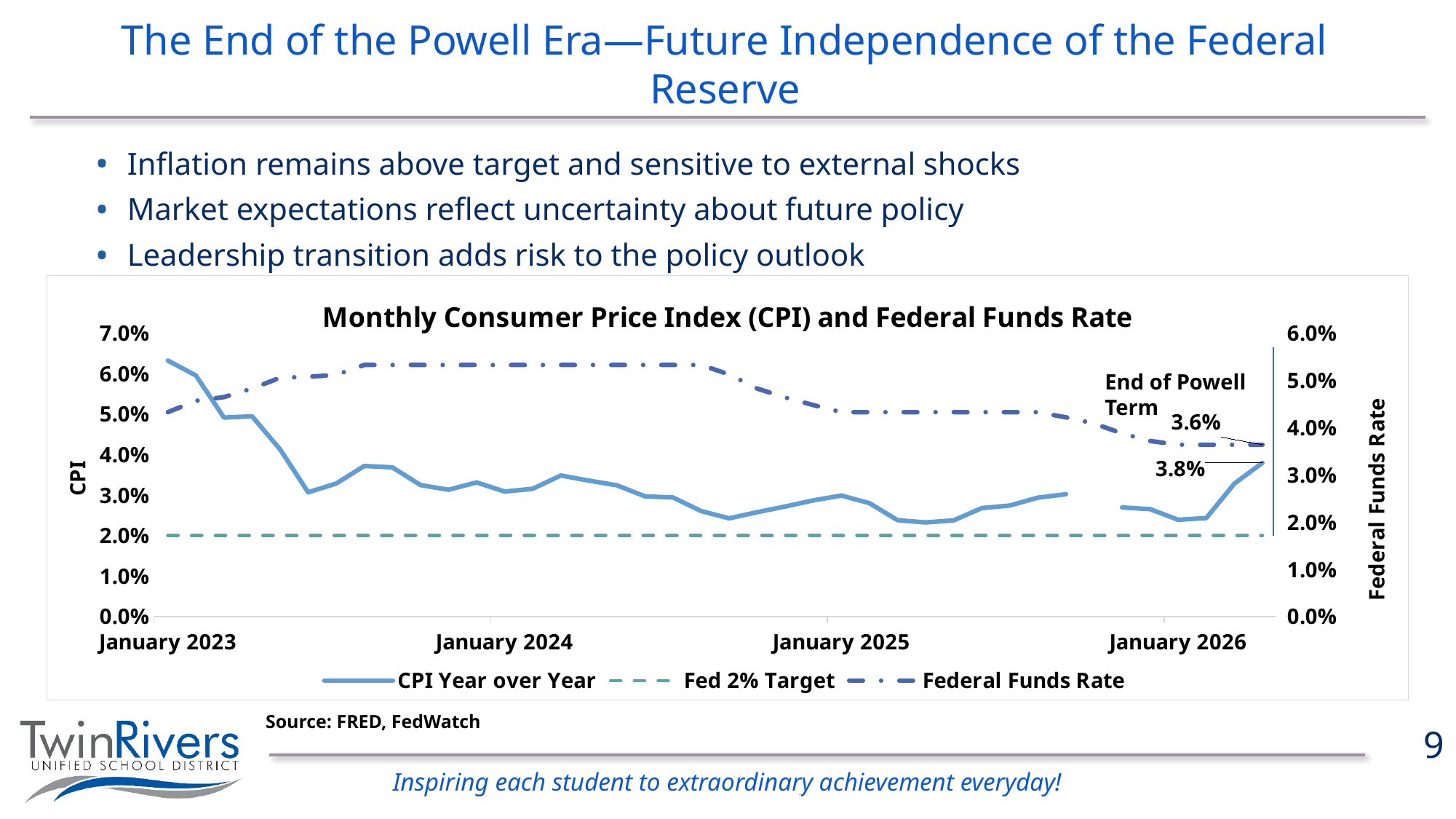
At the end of the series, which labeled value is larger: CPI Year over Year or the Federal Funds Rate? CPI Year over Year Does CPI Year over Year rise or fall during the first half of 2023? fall What event is annotated near the right end of the chart? End of Powell Term What kind of chart is shown on the slide? Line chart Is the Federal Funds Rate at January 2024 greater or less than 5.0%? greater Does the Federal Funds Rate rise or fall between mid-2024 and January 2026? fall What is the labeled value of the Federal Funds Rate at the end of the series? 3.6% How many series does the chart legend list? 3 What is the labeled value of CPI Year over Year at the end of the series? 3.8% What is the title of the chart? Monthly Consumer Price Index (CPI) and Federal Funds Rate Is the CPI Year over Year value at January 2023 greater or less than 6.0%? greater What is the difference between the final labeled CPI Year over Year value (3.8%) and the final labeled Federal Funds Rate value (3.6%)? 0.2%